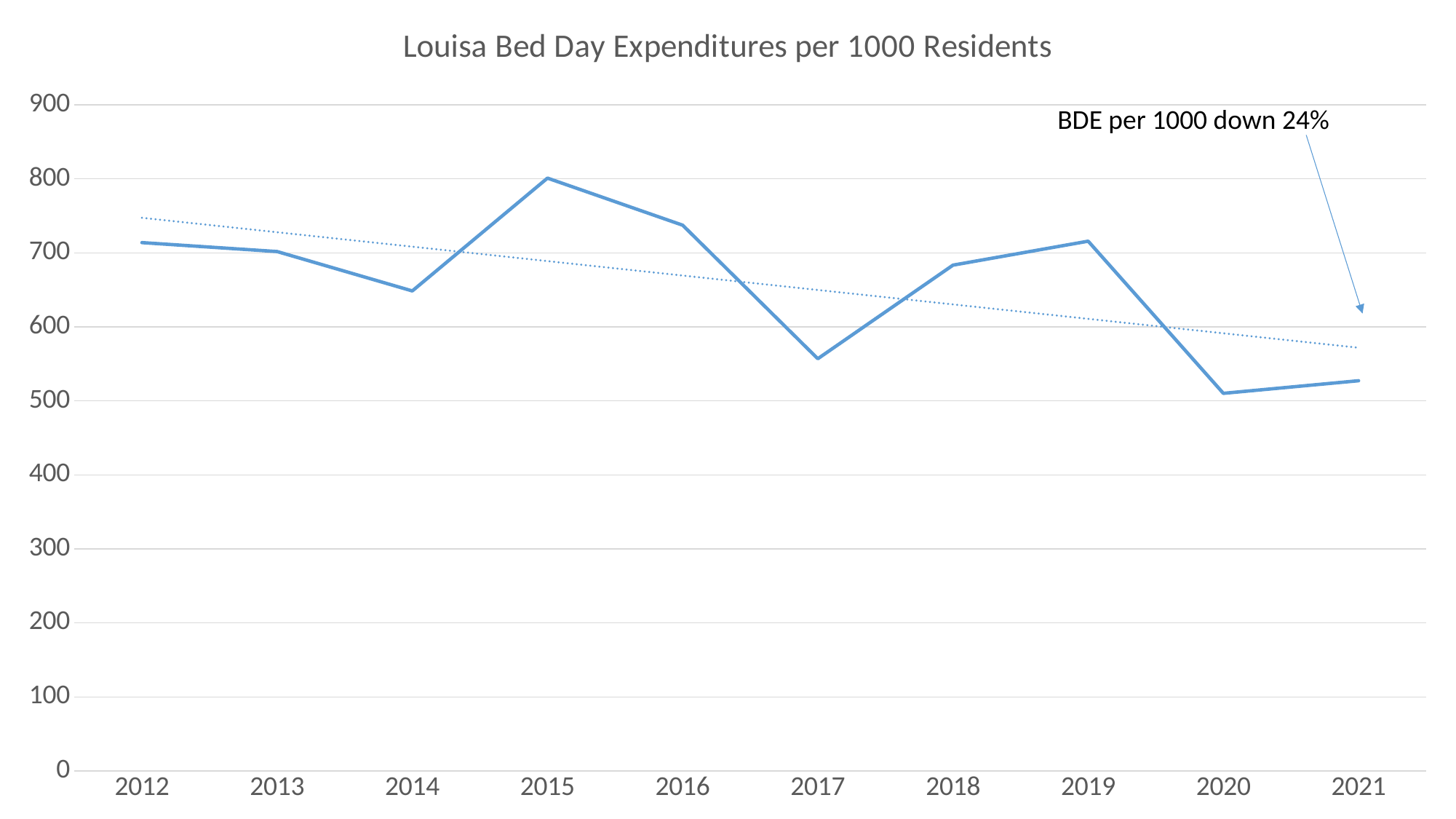
Which year has the highest bed day expenditures per 1000 residents? 2015 How many years are plotted along the x axis? 10 According to the annotation on the chart, by what percentage is BDE per 1000 down? 24% Overall, do the values rise or fall from 2012 to 2021? fall Is the value for 2017 greater or less than 600? less What kind of chart is shown on the slide? line chart Is the value for 2015 greater or less than 700? greater Is the value for 2014 greater or less than 700? less Which year has the lowest bed day expenditures per 1000 residents? 2020 Which year has the larger value, 2015 or 2017? 2015 What is the title of the chart? Louisa Bed Day Expenditures per 1000 Residents